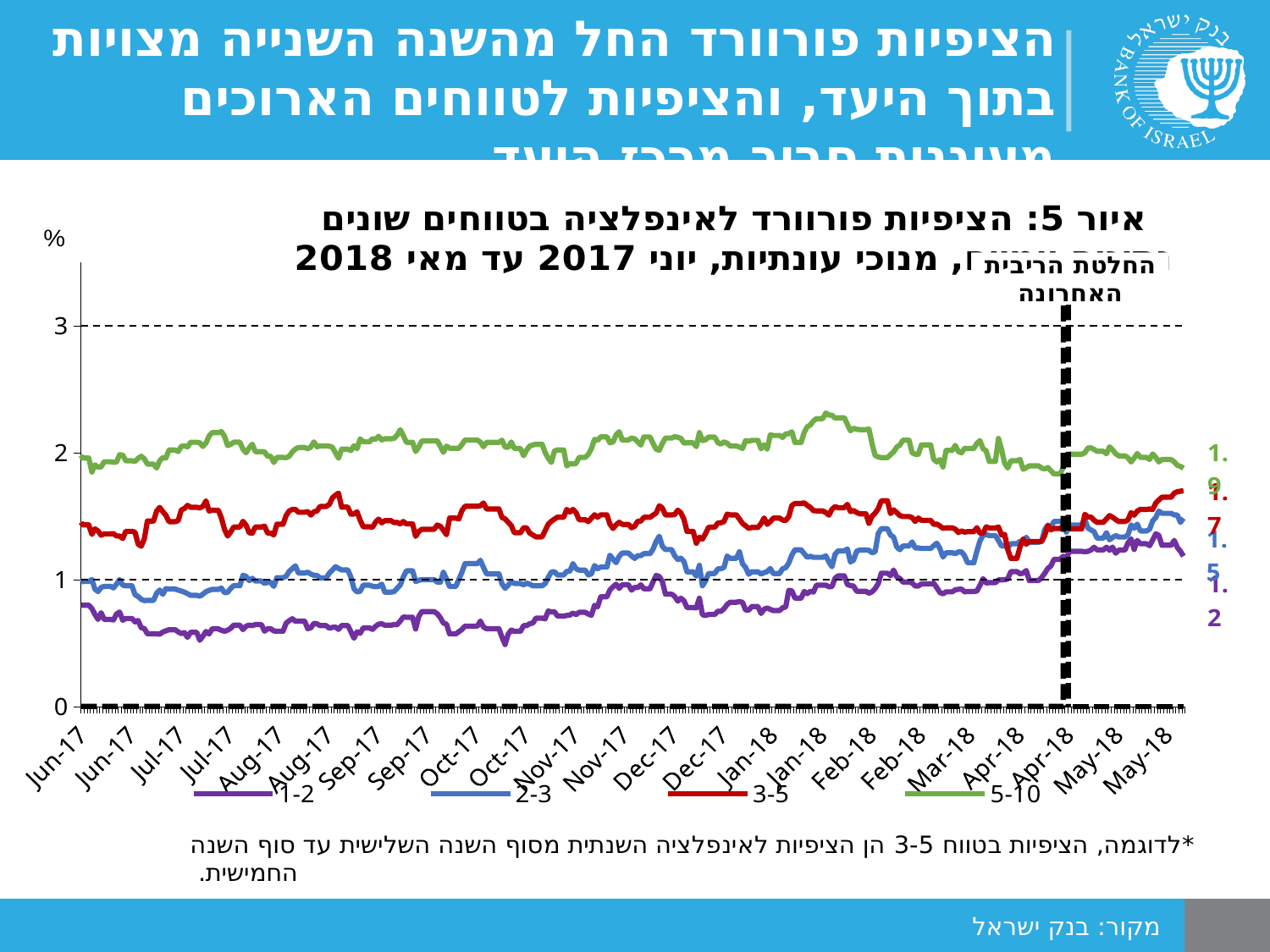
What is the final labelled value of the 3-5 series? 1.7 What kind of chart is shown on the slide? line chart What is the final labelled value of the 2-3 series? 1.5 What is the final labelled value of the 1-2 series? 1.2 Does the 1-2 series rise or fall from Jun-17 to May-18? rise Is the value of the 1-2 series in Jun-17 greater or less than 1? less Which series has the lowest value at the end of the period? 1-2 How many series does the legend list? 4 What is the difference between the final labelled values of the 5-10 and 1-2 series? 0.7 What are the four series listed in the legend? 1-2, 2-3, 3-5, 5-10 Which series has the highest value at the end of the period? 5-10 What is the final labelled value of the 5-10 series? 1.9